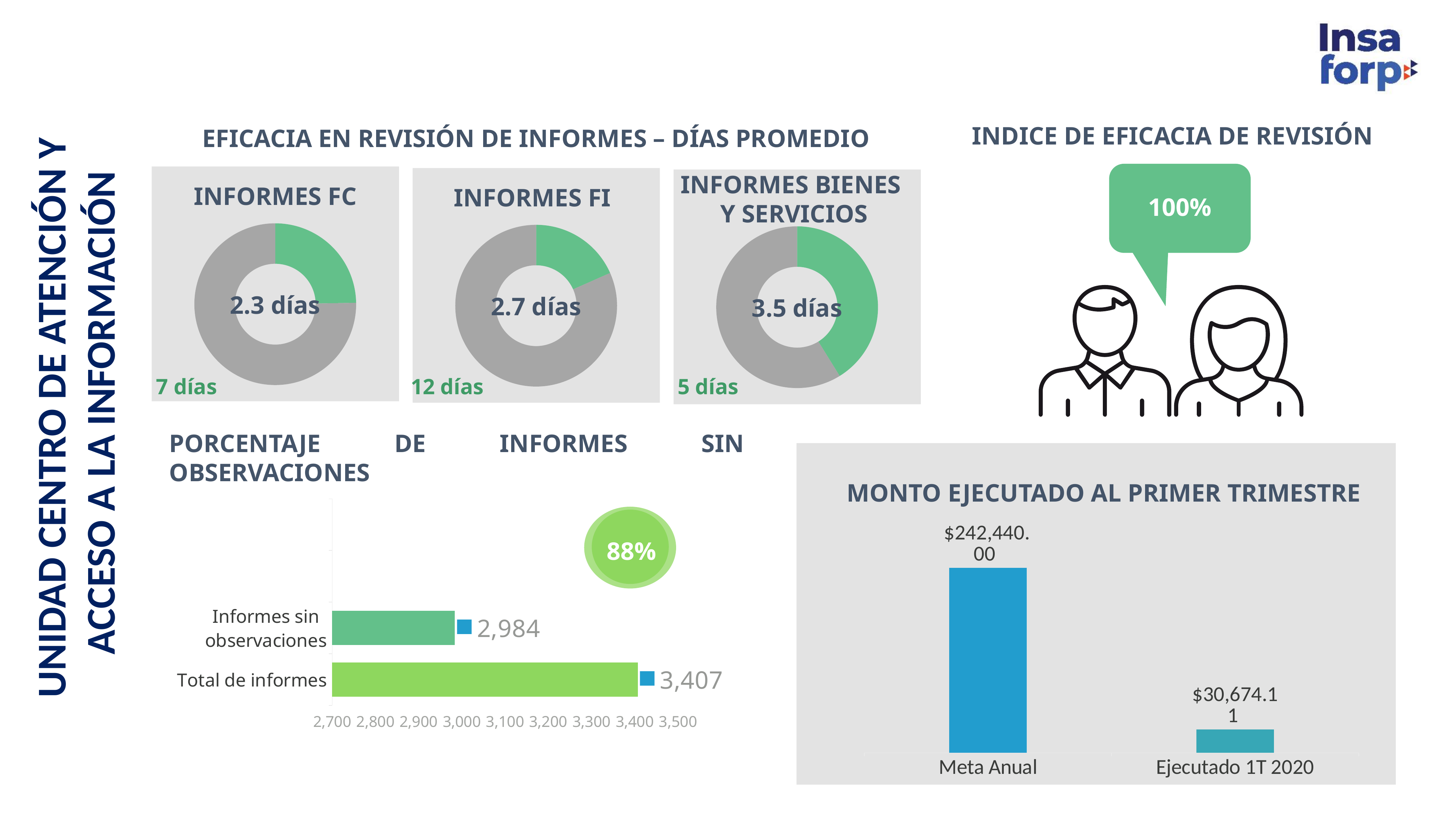
In the 'Informes Bienes y Servicios' donut chart, what average number of days is shown in the centre? 3.5 días In the 'Porcentaje de informes sin observaciones' chart, what is the difference between 'Total de informes' and 'Informes sin observaciones'? 423 In the 'Monto ejecutado al primer trimestre' chart, how many categories are plotted? 2 In the 'Porcentaje de informes sin observaciones' chart, what is the value for 'Total de informes'? 3,407 In the 'Porcentaje de informes sin observaciones' chart, what is the value for 'Informes sin observaciones'? 2,984 Among the three donut charts under 'Eficacia en revisión de informes – días promedio', which report type has the highest average days? Informes Bienes y Servicios Among the three donut charts under 'Eficacia en revisión de informes – días promedio', which report type has the lowest average days? Informes FC In the 'Monto ejecutado al primer trimestre' chart, what is the value for 'Ejecutado 1T 2020'? $30,674.11 In the 'Informes FC' donut chart, what average number of days is shown in the centre? 2.3 días What kind of chart is the 'Porcentaje de informes sin observaciones' chart? bar chart In the 'Informes FI' donut chart, what average number of days is shown in the centre? 2.7 días In the 'Monto ejecutado al primer trimestre' chart, what is the value for 'Meta Anual'? $242,440.00